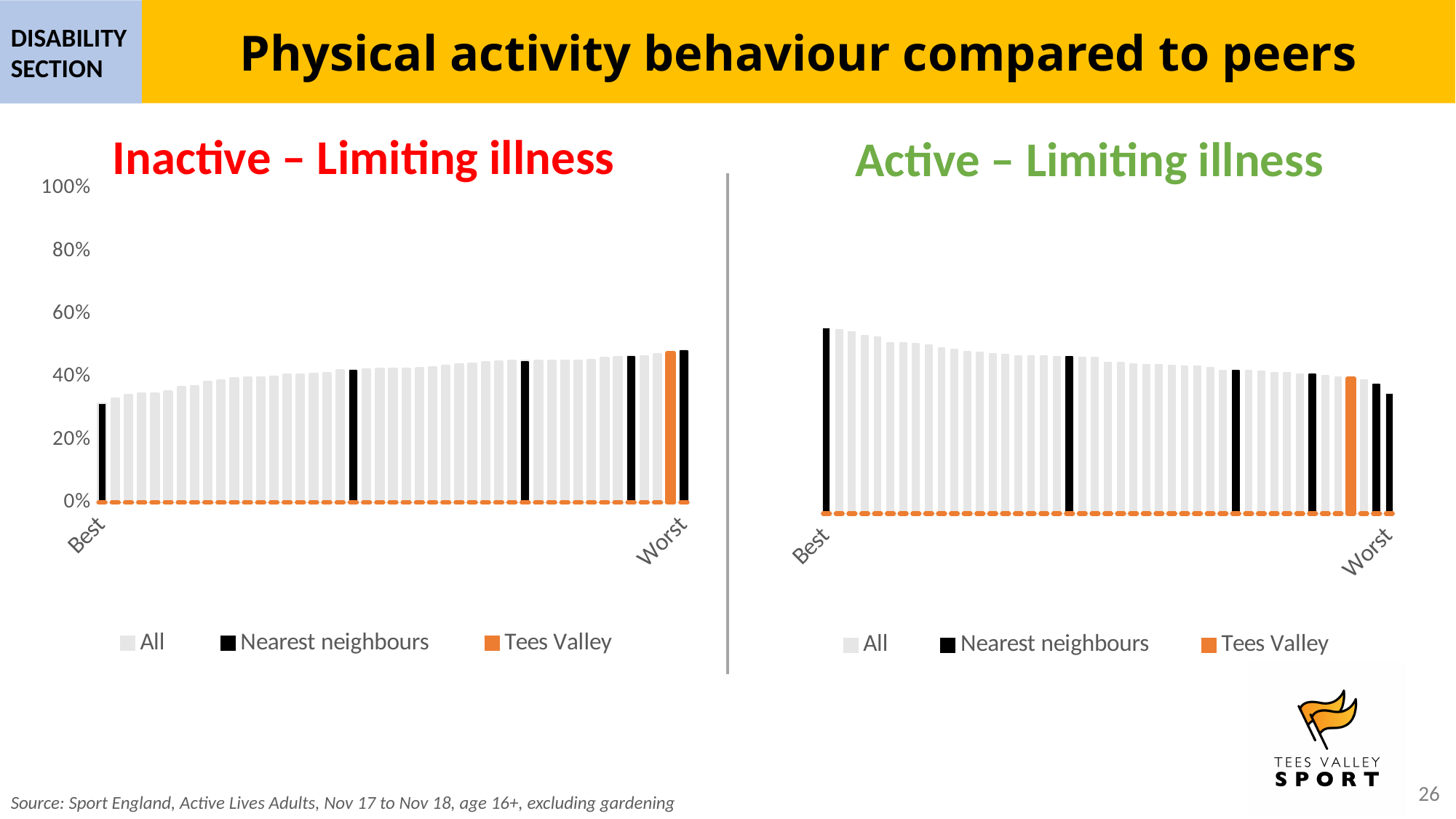
In the 'Inactive – Limiting illness' chart, is the value of the first (Best) bar greater or less than 40%? less In the 'Inactive – Limiting illness' chart, is the Tees Valley value greater or less than 60%? less In the 'Inactive – Limiting illness' chart, is the Tees Valley value greater or less than 40%? greater What colour represents Tees Valley in the legend of the 'Inactive – Limiting illness' chart? orange What is the title of the chart on the right side of the slide? Active – Limiting illness What kind of chart is the 'Inactive – Limiting illness' chart? bar chart In the 'Active – Limiting illness' chart, which is larger: the Tees Valley bar or the first (Best) bar? the first (Best) bar In the 'Active – Limiting illness' chart, do the bar values rise or fall from Best to Worst? fall In the 'Inactive – Limiting illness' chart, which is larger: the Tees Valley bar or the first (Best) bar? Tees Valley In the 'Inactive – Limiting illness' chart, do the bar values rise or fall from Best to Worst? rise How many series does the legend of the 'Active – Limiting illness' chart list? 3